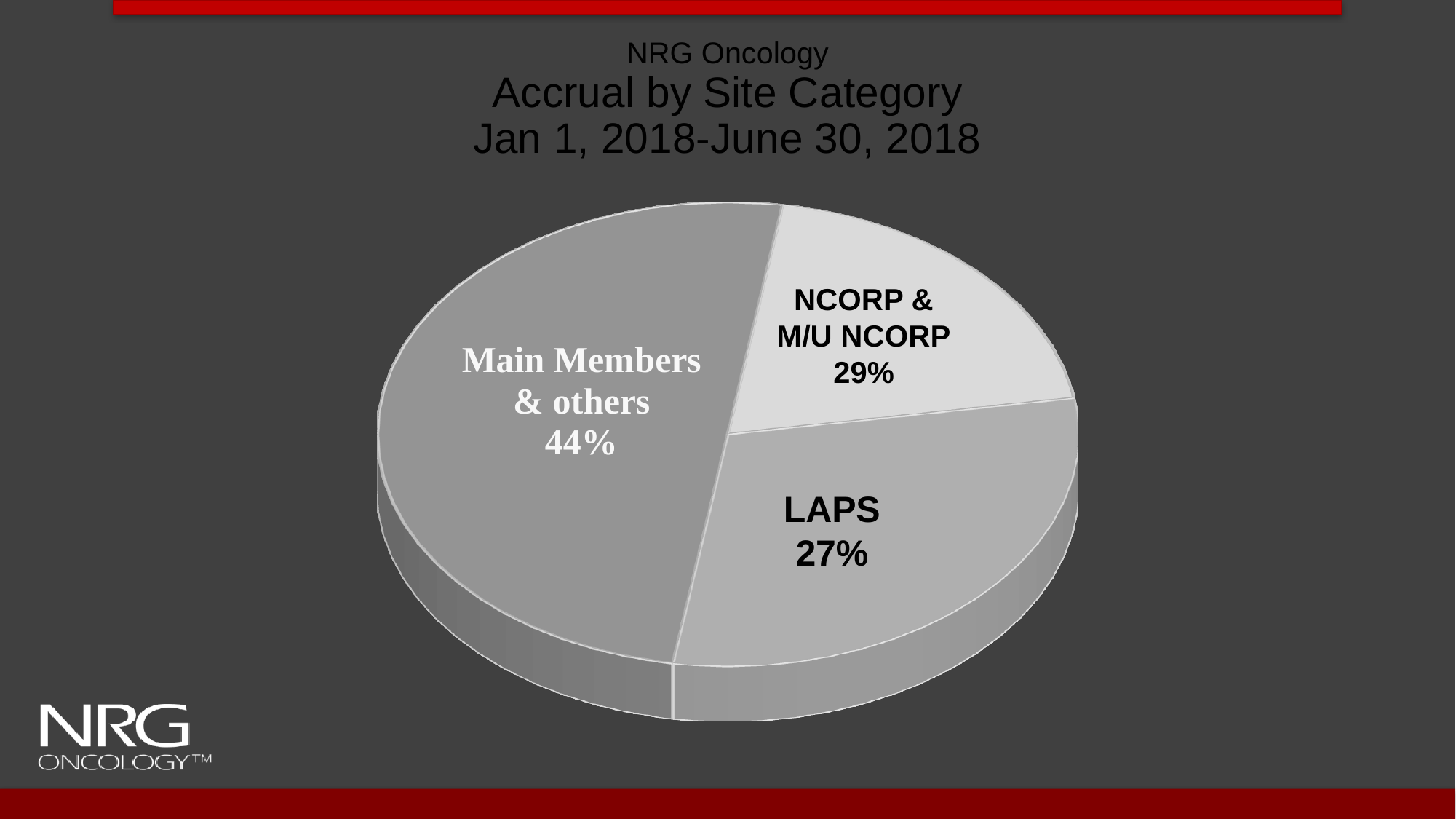
Which site category has the largest share of accrual? Main Members & others What share of accrual is attributed to Main Members & others? 44% What is the combined share of NCORP & M/U NCORP and LAPS? 56% What share of accrual is attributed to NCORP & M/U NCORP? 29% Which has a larger share of accrual, NCORP & M/U NCORP or LAPS? NCORP & M/U NCORP Which site category has the smallest share of accrual? LAPS What kind of chart is shown on the slide? Pie chart What is the difference in percentage points between NCORP & M/U NCORP and LAPS? 2 How many site categories are shown in the pie chart? 3 What is the difference in percentage points between Main Members & others and LAPS? 17 What share of accrual is attributed to LAPS? 27% What time period does the chart title say the accrual covers? Jan 1, 2018-June 30, 2018